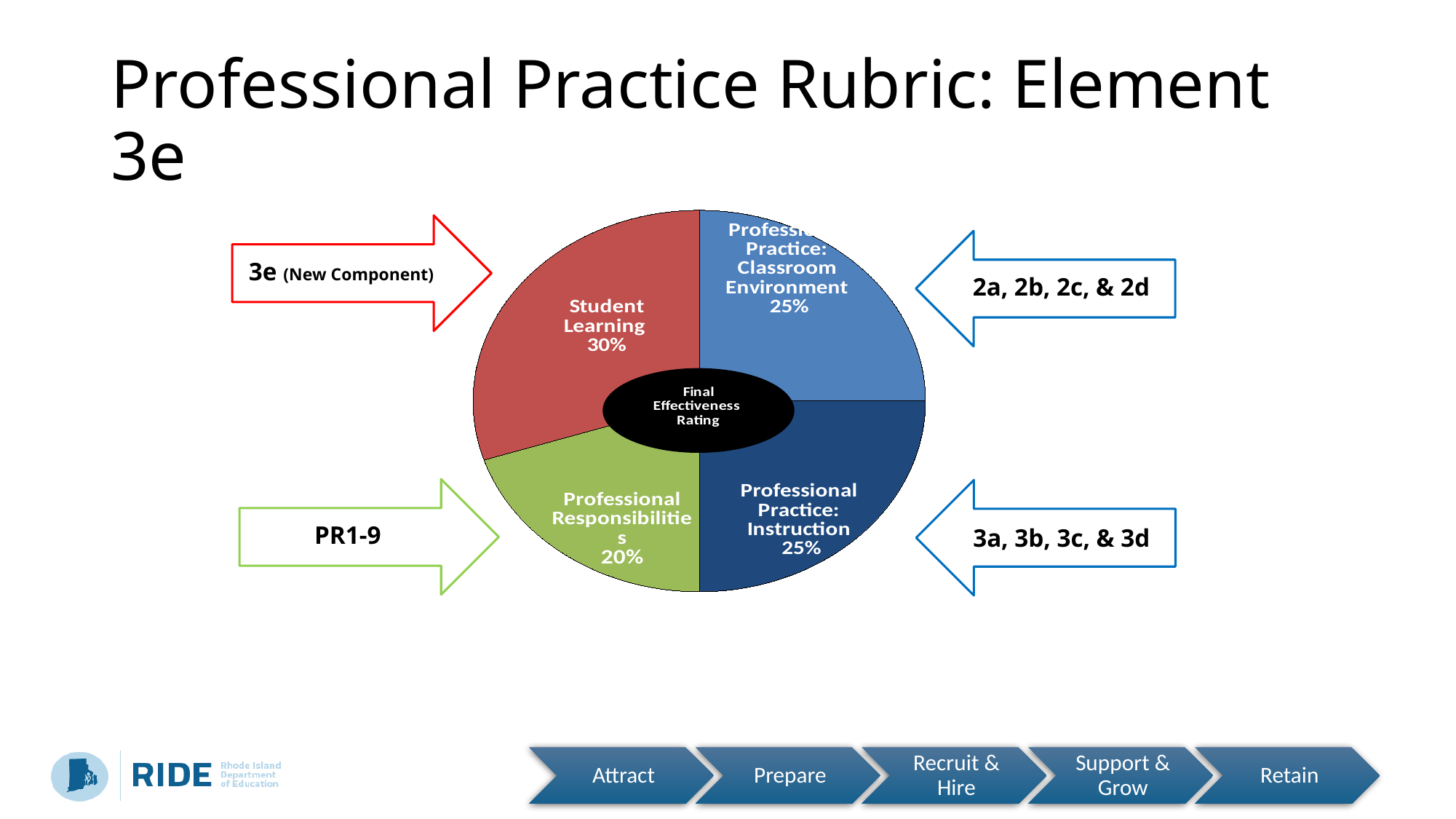
What share of the pie does Professional Practice: Instruction represent? 25% What is the combined share of the two Professional Practice slices (Classroom Environment and Instruction)? 50% Which slice of the pie is the largest? Student Learning How many slices does the pie chart have? 4 What share of the pie does Professional Practice: Classroom Environment represent? 25% Which slice of the pie is the smallest? Professional Responsibilities What text appears in the black oval at the center of the pie chart? Final Effectiveness Rating Which is larger, Student Learning or Professional Practice: Instruction? Student Learning What kind of chart is shown on the slide? pie chart What share of the pie does Professional Responsibilities represent? 20% What share of the pie does Student Learning represent? 30% What is the difference in percentage points between Student Learning and Professional Responsibilities? 10